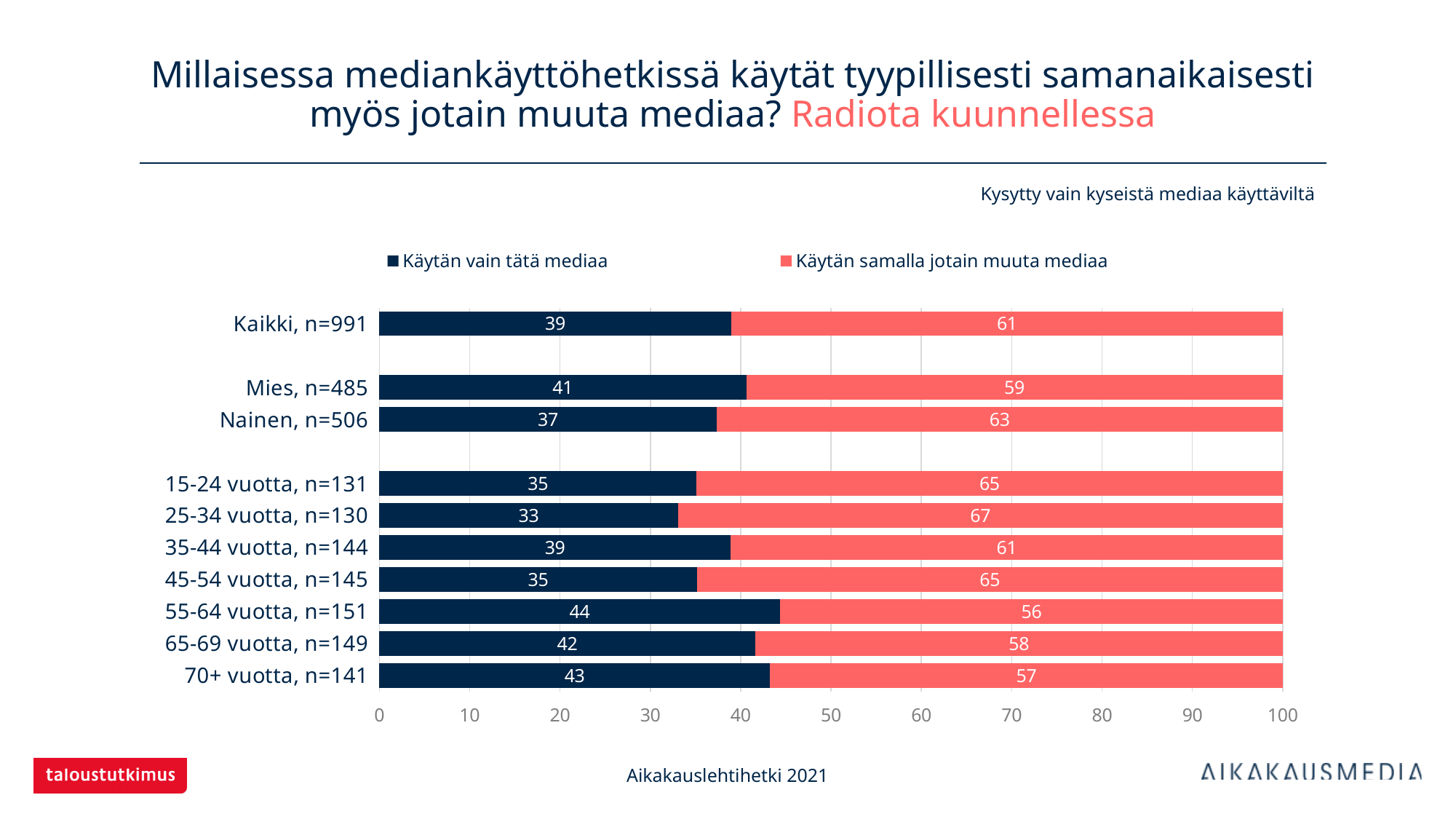
What is the value of "Käytän vain tätä mediaa" for Kaikki, n=991? 39 What colour represents the series "Käytän samalla jotain muuta mediaa"? Red (coral) What is the value of "Käytän samalla jotain muuta mediaa" for Nainen, n=506? 63 How many categories are shown on the chart? 10 What is the difference between the "Käytän vain tätä mediaa" values for Mies, n=485 and Nainen, n=506? 4 How many series does the legend list? 2 What is the total of the stacked bar for 65-69 vuotta, n=149? 100 What is the value of "Käytän vain tätä mediaa" for 55-64 vuotta, n=151? 44 Which category has the lowest value for "Käytän vain tätä mediaa"? 25-34 vuotta, n=130 Which is larger: the "Käytän samalla jotain muuta mediaa" value for 15-24 vuotta, n=131 or for 70+ vuotta, n=141? 15-24 vuotta, n=131 Which category has the highest value for "Käytän samalla jotain muuta mediaa"? 25-34 vuotta, n=130 What kind of chart is shown on the slide? Stacked bar chart